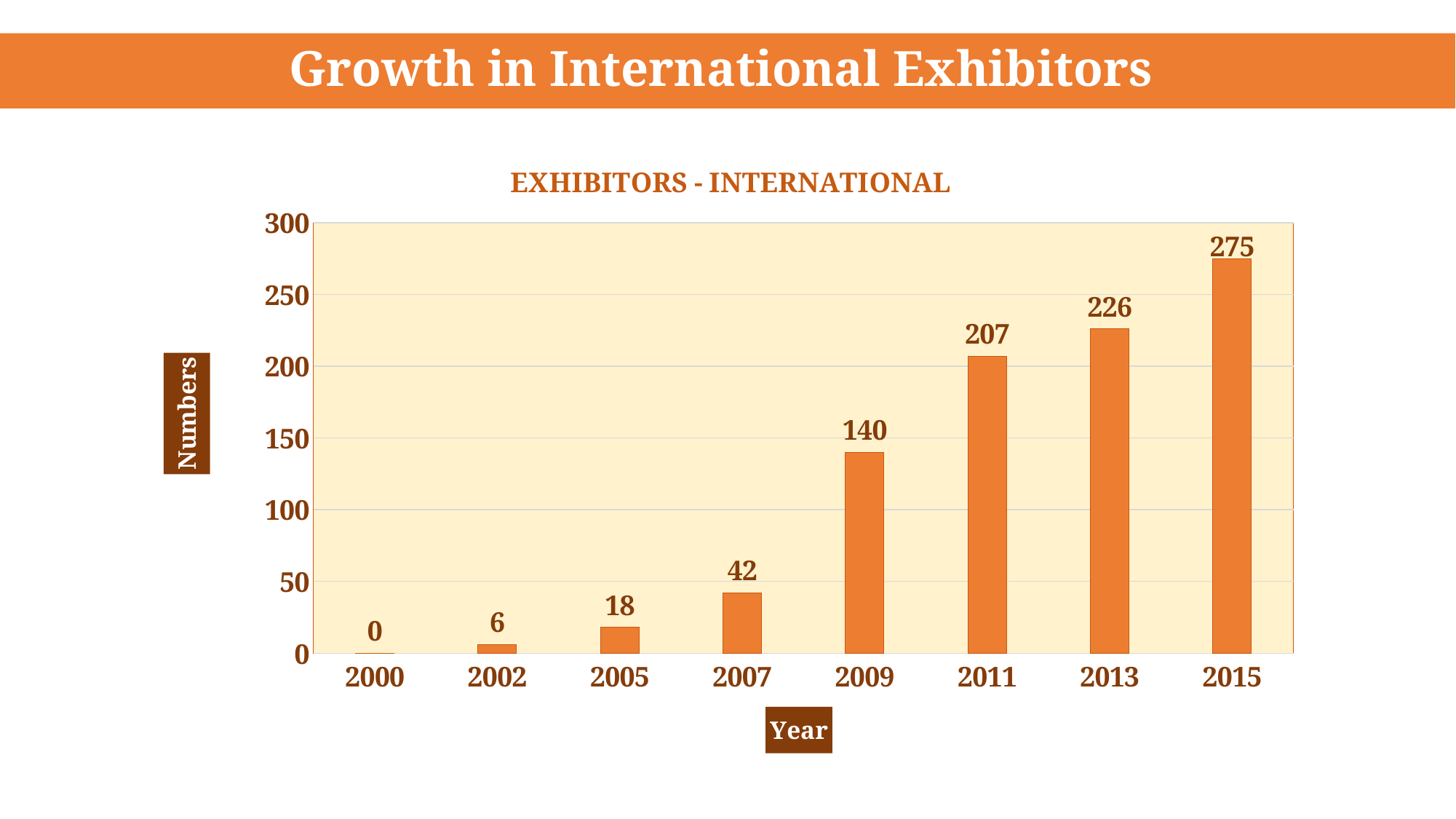
How many years are shown on the x axis? 8 Is the value for 2011 greater or less than 200? greater What is the difference between the values for 2009 and 2007? 98 What kind of chart is shown? bar chart What is the value for 2009? 140 What is the value for 2005? 18 Do the values rise or fall from 2000 to 2015? rise What is the difference between the values for 2015 and 2013? 49 Which year has the highest value? 2015 Which is larger, the value for 2011 or the value for 2009? 2011 What is the value for 2013? 226 Which year has the lowest value? 2000